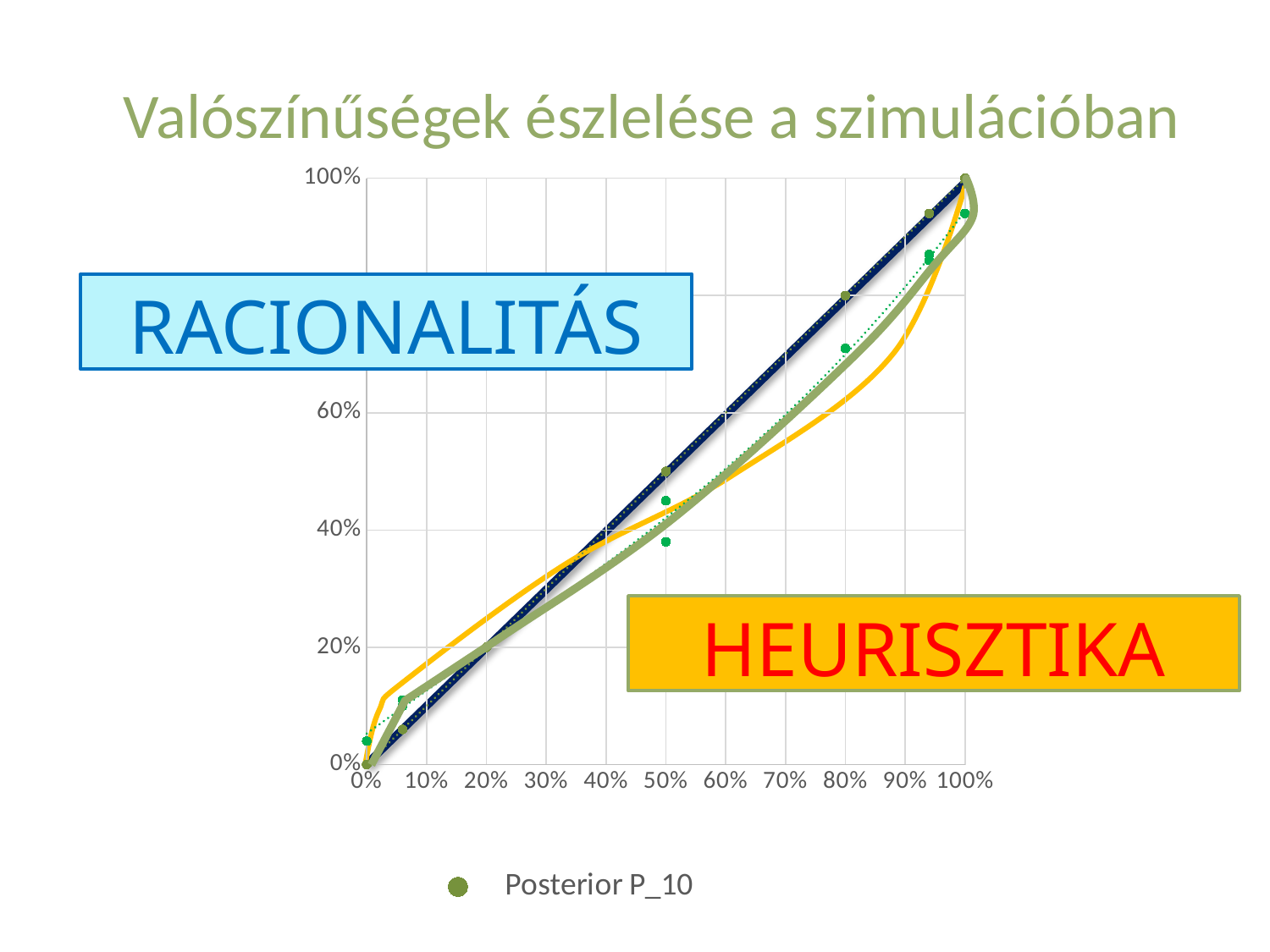
What kind of chart is shown on the slide? scatter chart How many tick labels are shown on the x axis of the chart? 11 Do the plotted values rise or fall as the x axis goes from 0% to 100%? rise What is the title of the chart on the slide? Valószínűségek észlelése a szimulációban What entry does the chart's legend list? Posterior P_10 How many series does the chart's legend list? 1 Is the value of the yellow line at x = 10% greater or less than 20%? less Is the value of the thick olive line at x = 90% greater or less than 60%? greater Is the value of the yellow line at x = 30% greater or less than 20%? greater